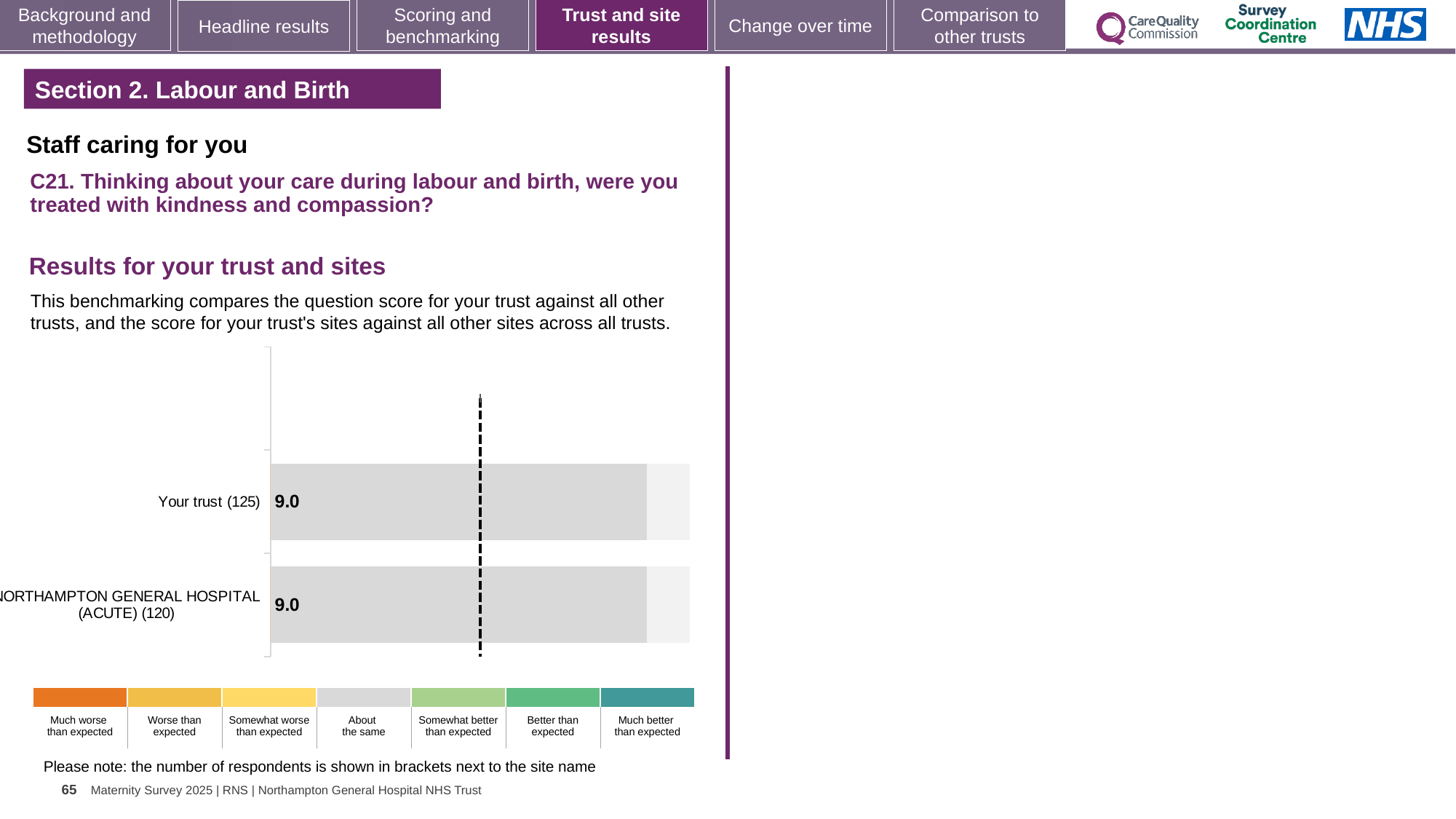
What is the difference between the score for Your trust and the score for Northampton General Hospital (Acute)? 0.0 What is the score shown for Northampton General Hospital (Acute) (120)? 9.0 What kind of chart is shown on the slide? Bar chart Is the score for Your trust larger than, smaller than, or equal to the score for Northampton General Hospital (Acute)? Equal (both 9.0) How many bars are plotted in the chart? 2 How many categories are shown in the colour key below the chart, from 'Much worse than expected' to 'Much better than expected'? 7 How many respondents are shown in brackets for Your trust? 125 What is the score shown for Your trust (125)? 9.0 Which survey question does the chart relate to? C21. Thinking about your care during labour and birth, were you treated with kindness and compassion? How many respondents are shown in brackets for Northampton General Hospital (Acute)? 120